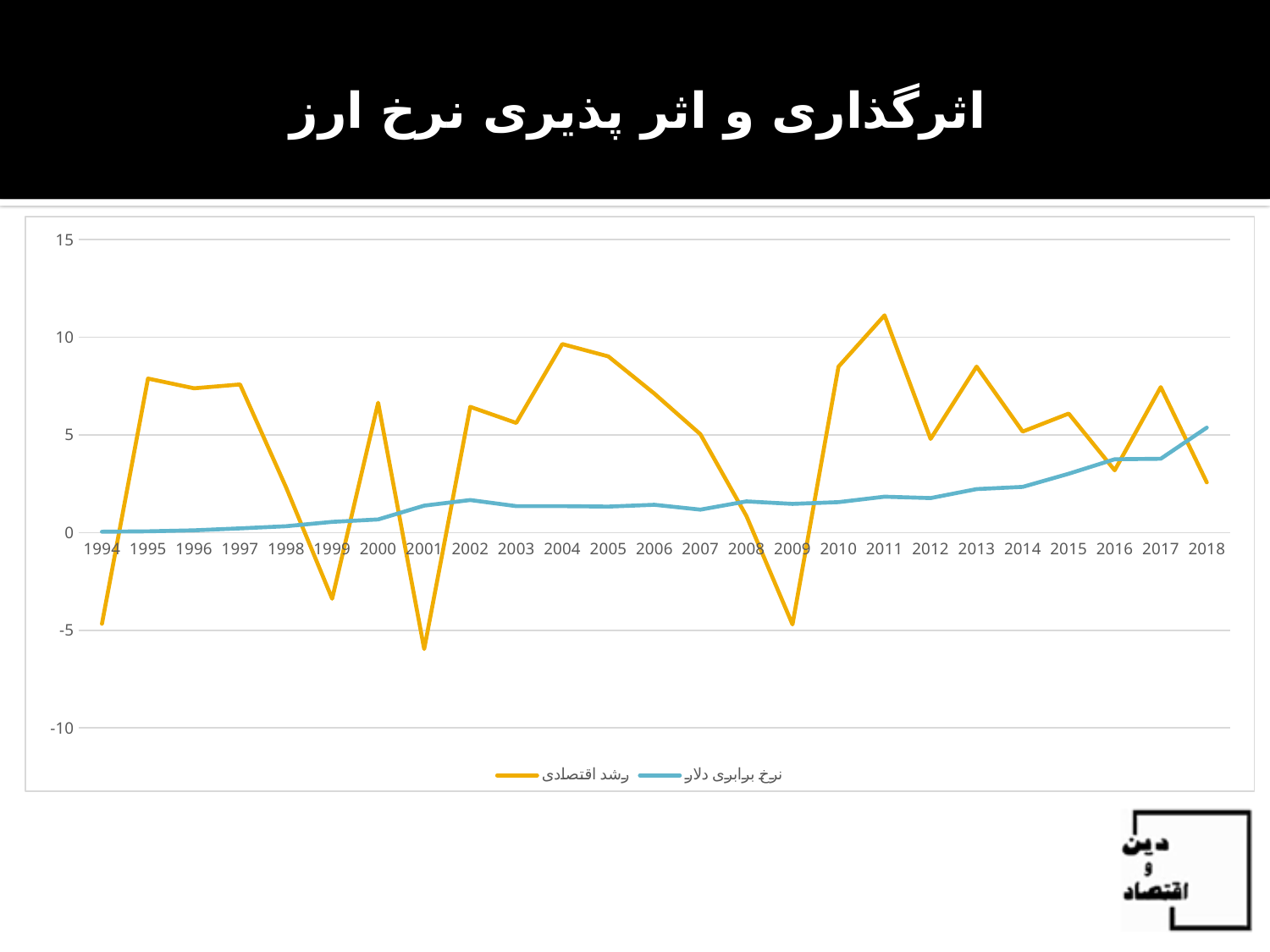
In 2009, which series has the larger value, رشد اقتصادی or نرخ برابری دلار? نرخ برابری دلار What kind of chart is shown on the slide? line chart Does the نرخ برابری دلار series generally rise or fall from 1994 to 2018? rise How many series does the legend list? 2 Is the value of رشد اقتصادی in 2001 greater or less than -5? less In which year does the رشد اقتصادی series reach its lowest value? 2001 Is the value of رشد اقتصادی in 2011 greater or less than 10? greater Is the value of نرخ برابری دلار in 2018 greater or less than 5? greater What is the first year shown on the x axis? 1994 How many years are shown along the x axis? 25 In which year does the رشد اقتصادی series reach its highest value? 2011 What is the last year shown on the x axis? 2018